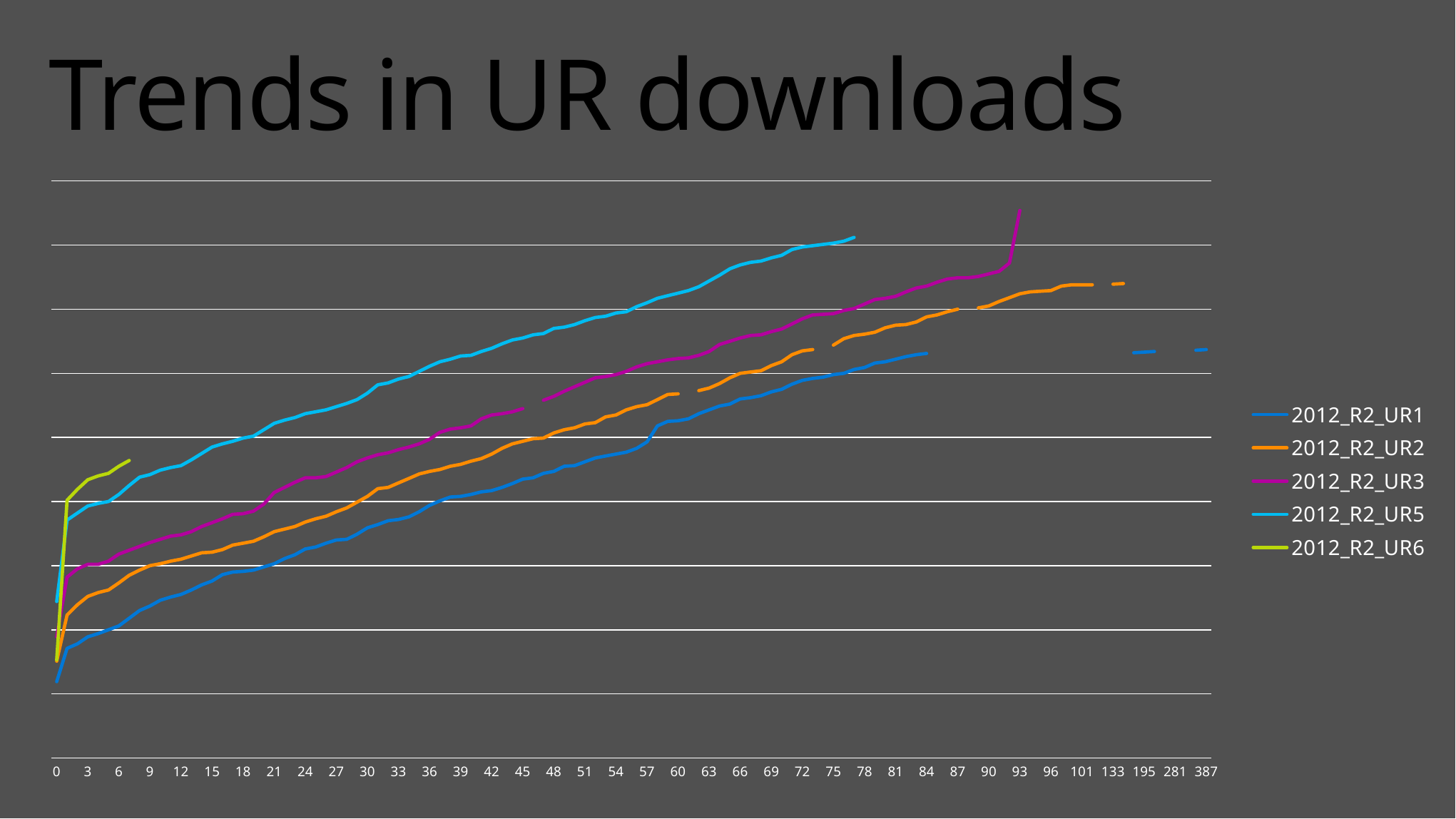
What is the title of the chart? Trends in UR downloads Which series covers the shortest range along the x axis? 2012_R2_UR6 How many series does the legend list? 5 Do the values for 2012_R2_UR2 rise or fall along the x axis? rise Which series is drawn in green? 2012_R2_UR6 What kind of chart is shown on the slide? line chart At x = 60, which is higher: 2012_R2_UR3 or 2012_R2_UR2? 2012_R2_UR3 At x = 30, which is higher: 2012_R2_UR5 or 2012_R2_UR1? 2012_R2_UR5 Do the values for 2012_R2_UR5 rise or fall along the x axis? rise Which series extends furthest along the x axis? 2012_R2_UR1 At x = 45, which is lower: 2012_R2_UR1 or 2012_R2_UR2? 2012_R2_UR1 Which series reaches the highest point on the chart? 2012_R2_UR3